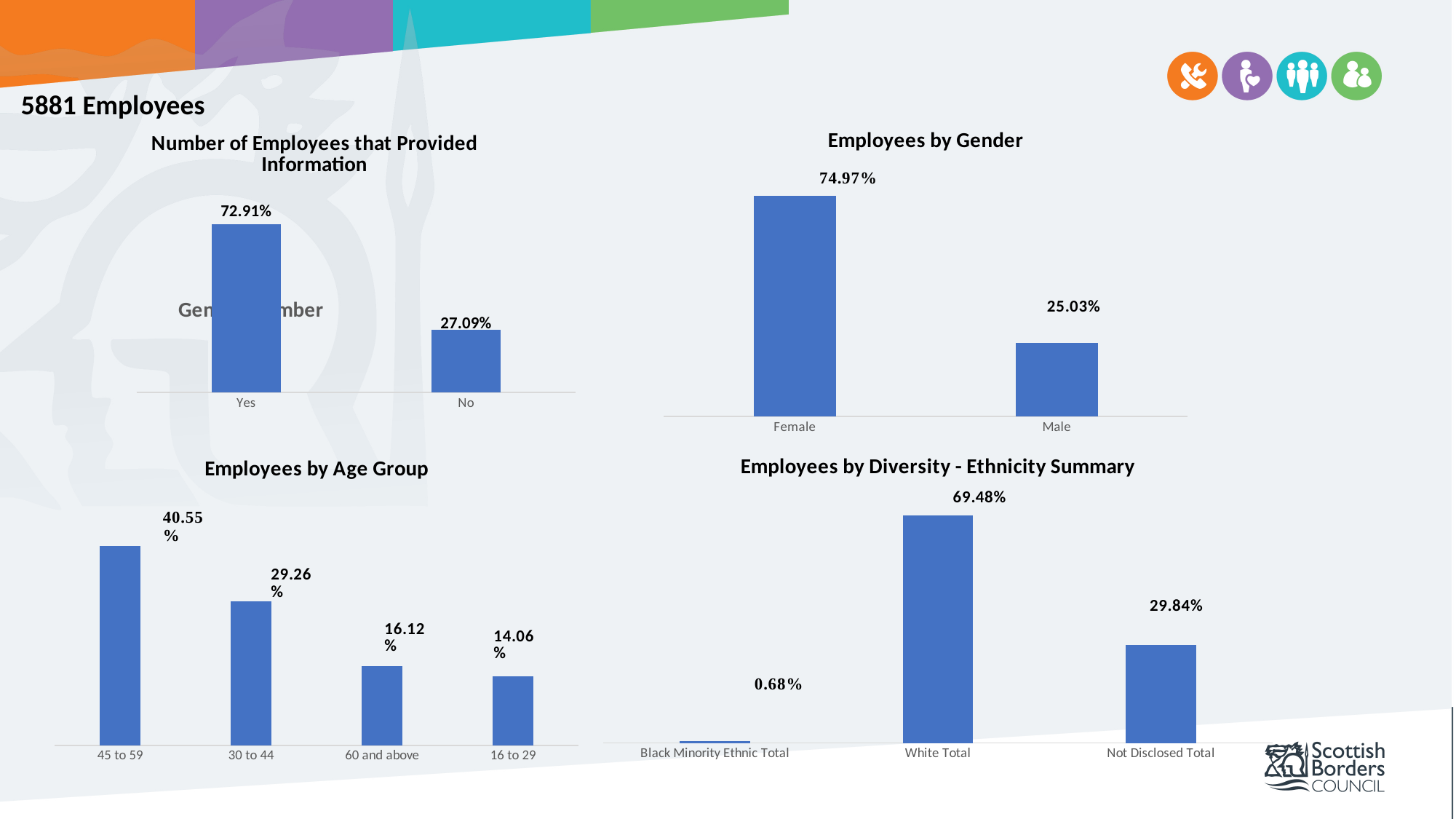
In the 'Employees by Diversity - Ethnicity Summary' chart, which category has the highest value? White Total In the 'Employees by Gender' chart, what is the value for Male? 25.03% In the 'Employees by Diversity - Ethnicity Summary' chart, what is the value for Black Minority Ethnic Total? 0.68% In the 'Number of Employees that Provided Information' chart, which is larger, Yes or No? Yes In the 'Number of Employees that Provided Information' chart, what is the value for Yes? 72.91% In the 'Employees by Gender' chart, what is the difference between the Female and Male values? 49.94 percentage points In the 'Employees by Age Group' chart, what is the value for 60 and above? 16.12% In the 'Employees by Age Group' chart, which age group has the lowest value? 16 to 29 How many categories are shown in the 'Employees by Age Group' chart? 4 In the 'Employees by Age Group' chart, what is the difference between the values for 45 to 59 and 30 to 44? 11.29 percentage points What type of chart is the 'Employees by Diversity - Ethnicity Summary' chart? Bar chart In the 'Employees by Age Group' chart, which age group has the highest value? 45 to 59